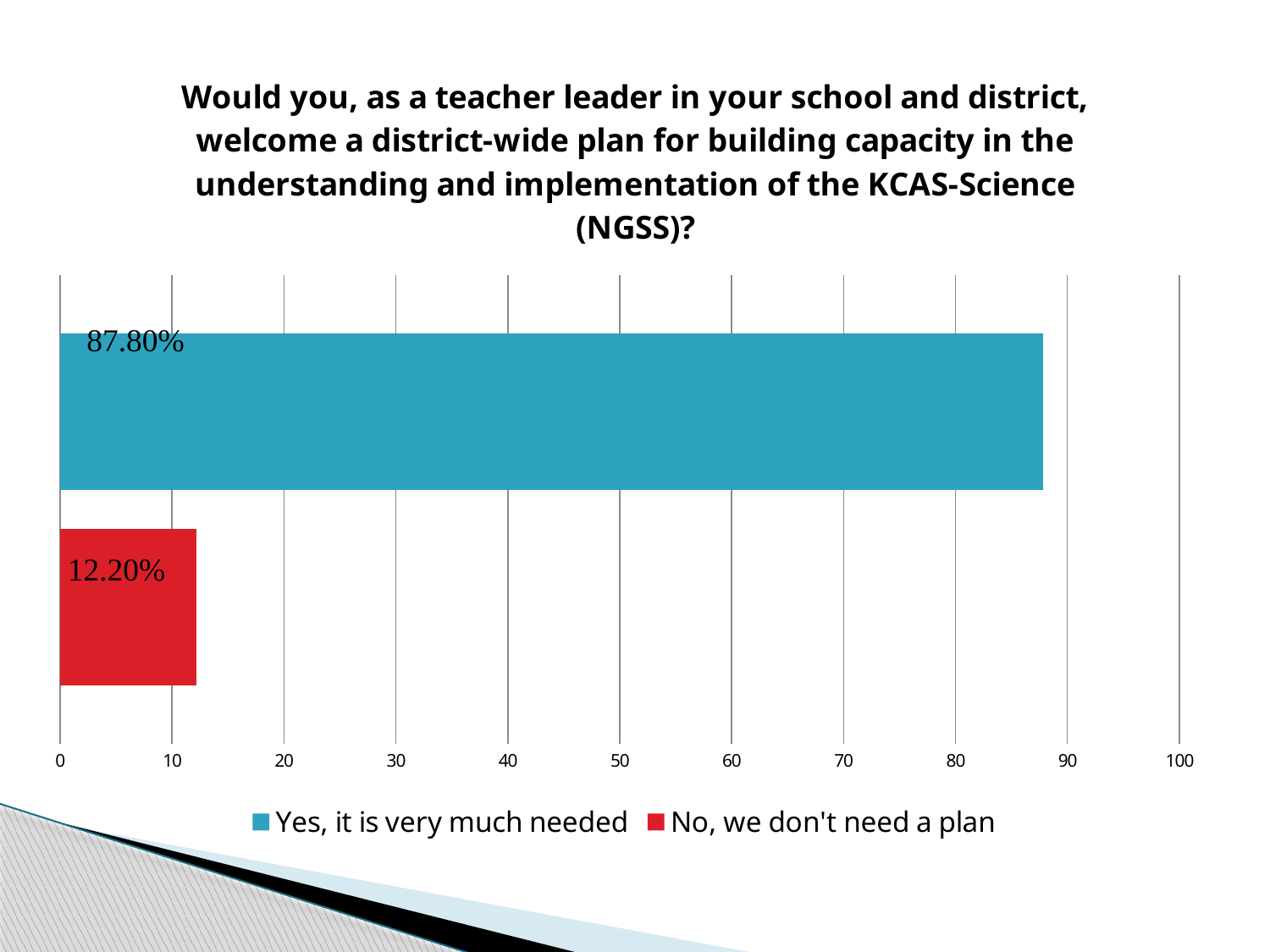
What type of chart is shown on the slide? Bar chart Is the value for "Yes, it is very much needed" greater or less than 80? greater Is the value for "No, we don't need a plan" greater or less than 20? less Which is larger: the share answering "Yes, it is very much needed" or the share answering "No, we don't need a plan"? Yes, it is very much needed How many entries does the legend list? 2 What colour is the bar for "No, we don't need a plan"? Red What percentage of respondents answered "No, we don't need a plan"? 12.20% What percentage of respondents answered "Yes, it is very much needed"? 87.80% How many bars are plotted on the chart? 2 What is the difference in percentage points between the "Yes" and "No" responses? 75.60% Which response received the highest percentage? Yes, it is very much needed Which response received the lowest percentage? No, we don't need a plan